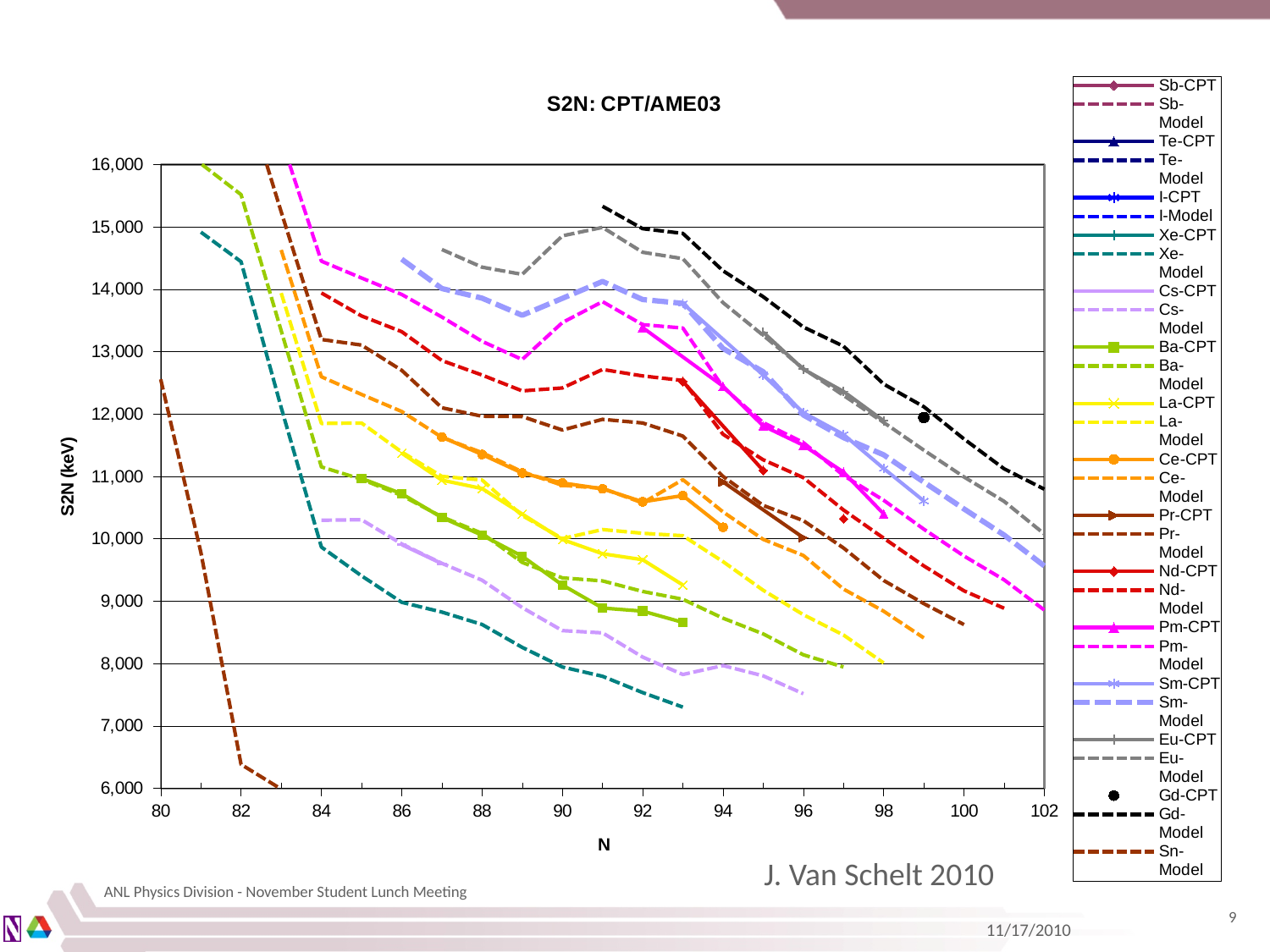
Do the S2N values generally rise or fall as N increases along the x axis? fall Which has the larger value, the Gd-CPT point at N = 99 or the Ba-CPT point at N = 93? Gd-CPT What kind of chart is shown on the slide? line chart What is the title of the chart? S2N: CPT/AME03 Is the Pm-CPT value at N = 98 greater or less than 10,000? greater Is the Xe-Model value at N = 93 greater or less than 8,000? less Is the Gd-CPT value at N = 99 greater or less than 11,000? greater At N = 93, which series has the larger value, Ba-CPT or La-CPT? La-CPT What is the label of the vertical axis? S2N (keV) How many series does the legend list? 29